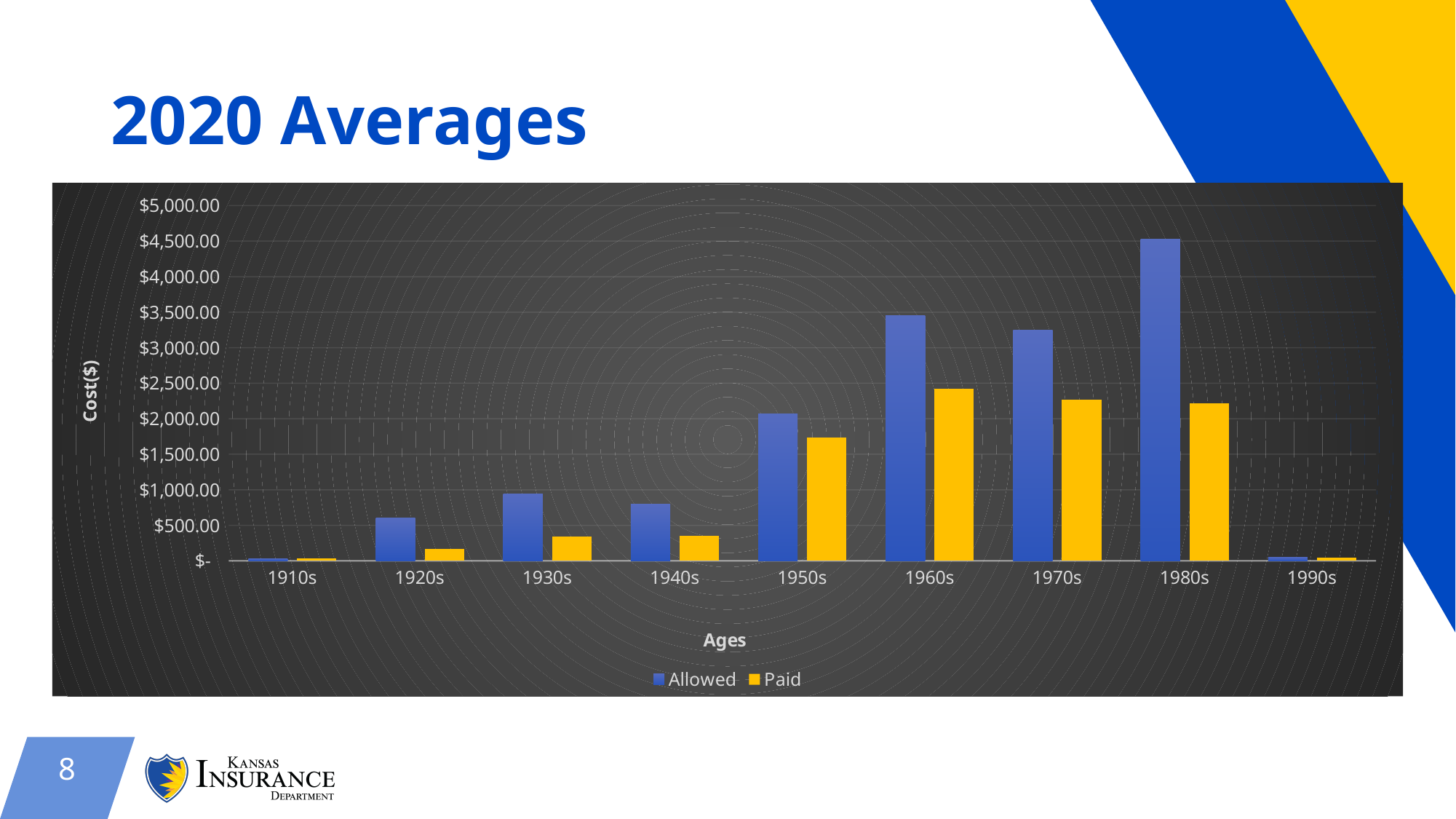
Is the Paid value for the 1920s greater or less than $500.00? less Is the Allowed value for the 1930s greater or less than $1,000.00? less How many series does the legend list? 2 Which colour represents the Paid series? yellow What is the title of the vertical axis? Cost($) How many age categories are shown on the x axis? 9 In the 1980s, which is larger, the Allowed value or the Paid value? Allowed What kind of chart is shown on the slide? bar chart Which age category has the highest Allowed value? 1980s Is the Allowed value for the 1980s greater or less than $4,000.00? greater